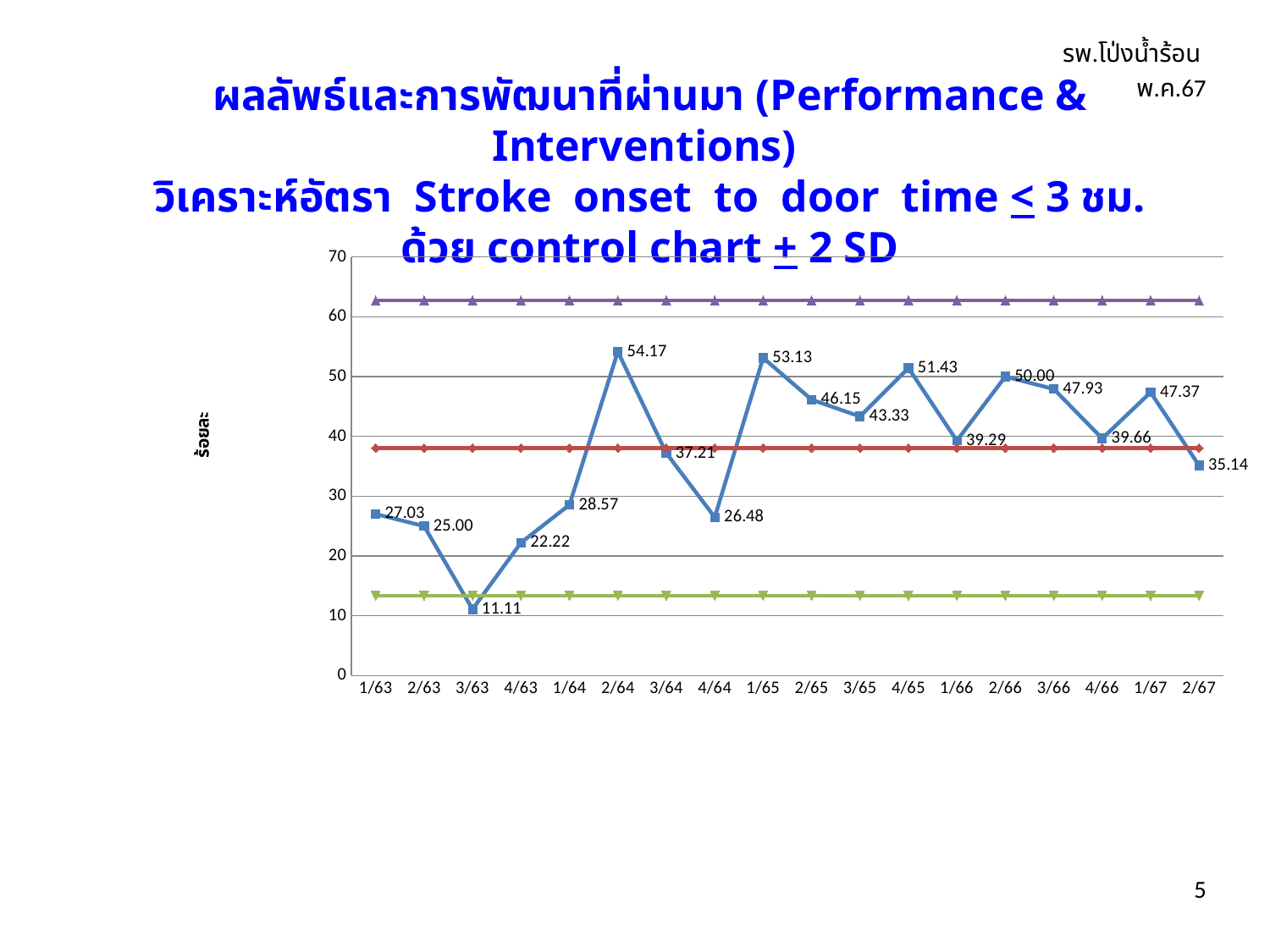
What is the value for 2/64? 54.17 What is the difference between the values for 2/64 and 3/64? 16.96 How many periods are shown on the x axis? 18 Which period has the highest plotted value? 2/64 Is the lower control line (green) greater or less than 20? less Which period has the lowest plotted value? 3/63 Is the upper control line (purple) greater or less than 60? greater What kind of chart is this? line chart What is the value for 2/67? 35.14 Do the values rise or fall from 1/63 to 3/63? fall What is the value for 3/63? 11.11 Which is larger, the value for 1/65 or the value for 4/65? 1/65